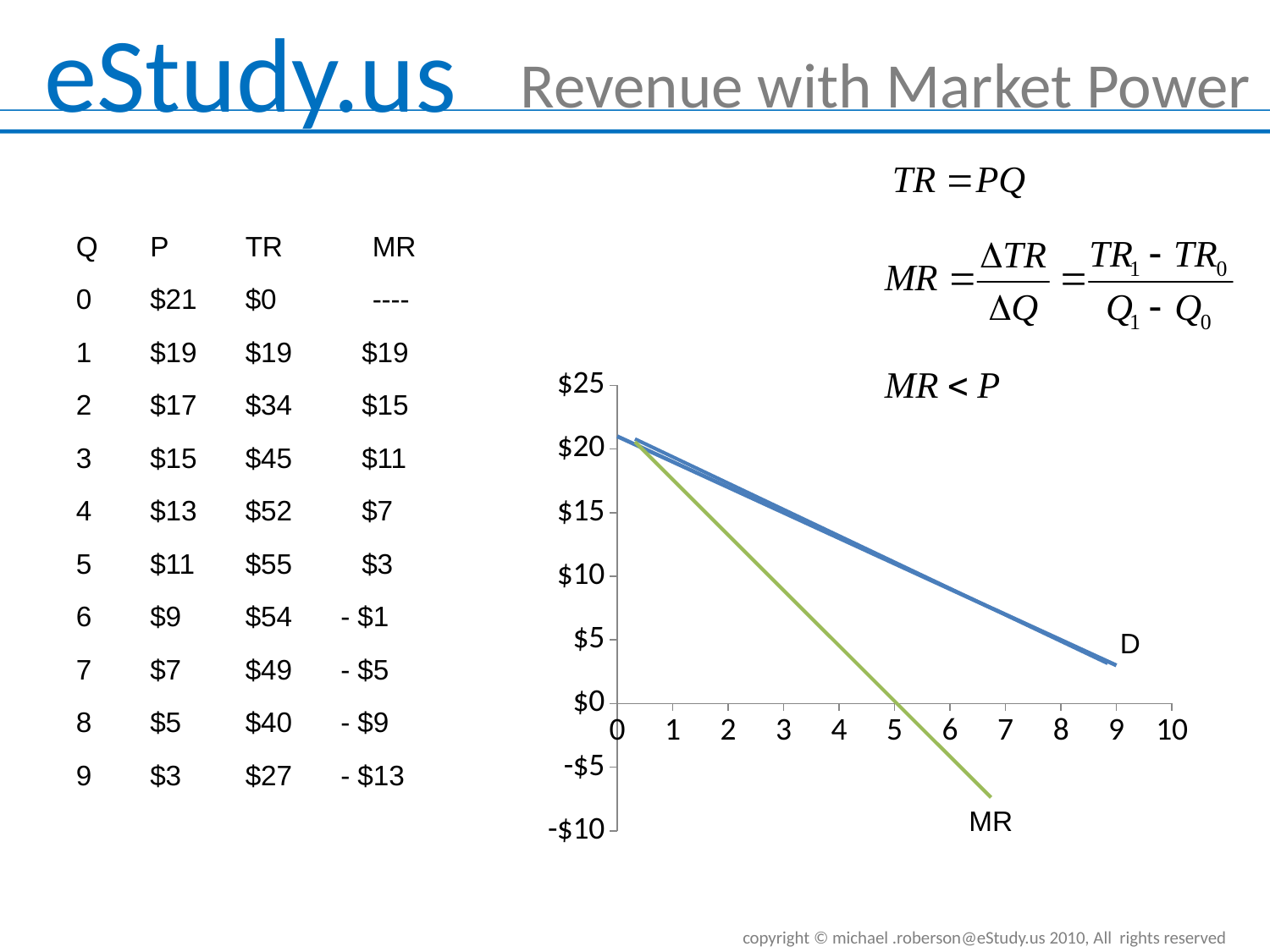
How many lines are plotted on the chart? 2 Is the value of the D line at a quantity of 2 greater or less than $15? greater Is the value of the D line at a quantity of 9 greater or less than $5? less Does the MR line rise or fall as quantity increases along the x axis? fall At a quantity of 5, which line is higher on the chart, D or MR? D Which line falls more steeply on the chart, D or MR? MR What are the labels of the two lines on the chart? D and MR What is the lowest value shown on the chart's vertical axis? -$10 What kind of chart is shown on the slide? line chart Does the D line rise or fall as quantity increases along the x axis? fall